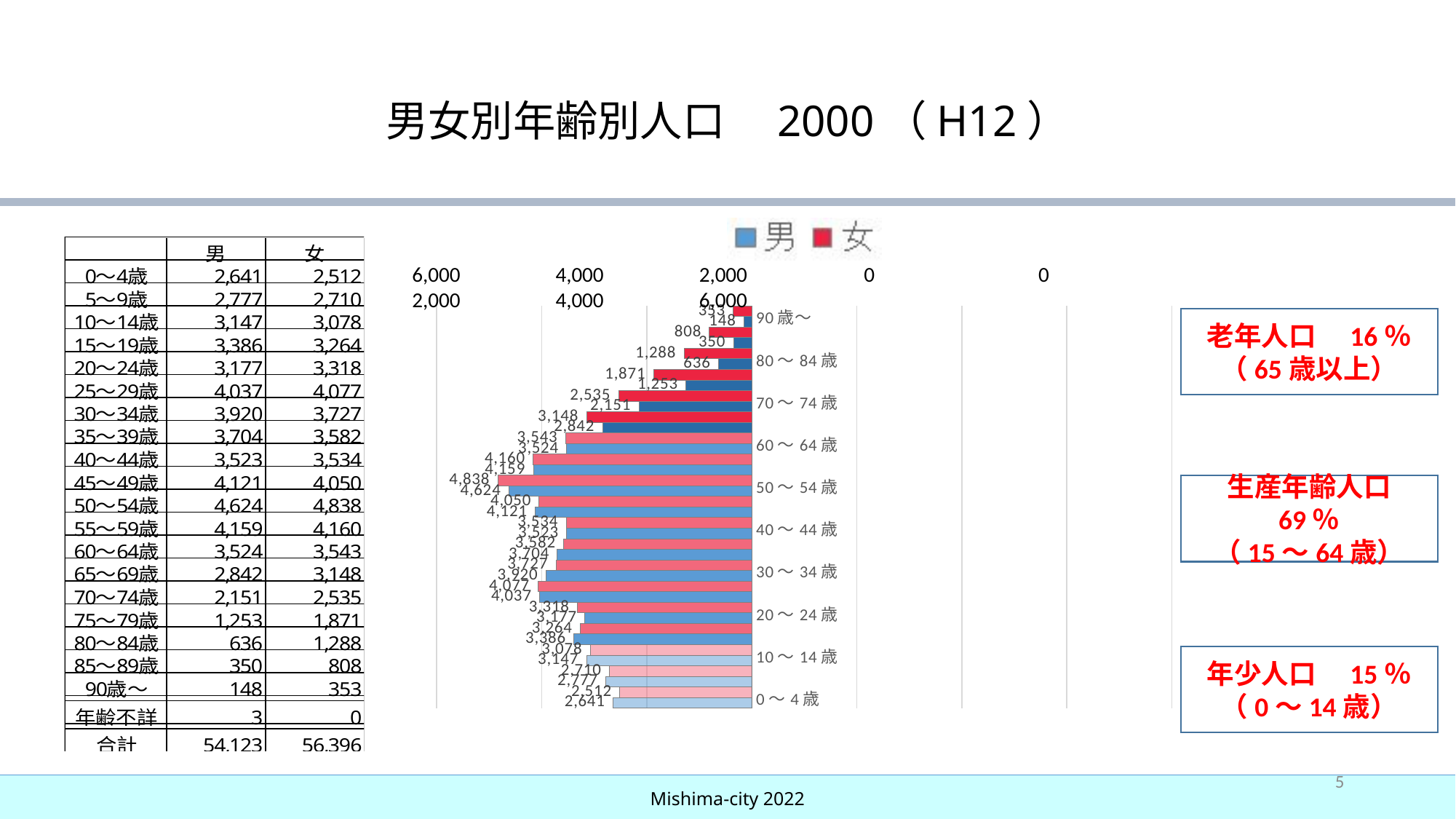
Which age group has the highest 女 value? 50〜54歳 How many age groups are plotted in the chart? 19 What is the difference between the 女 and 男 values for the 80〜84歳 age group? 652 What kind of chart is shown on the slide? bar chart What are the two legend entries of the chart? 男 and 女 How many series does the chart legend list? 2 Which age group has the lowest 男 value? 90歳〜 Which age group has the highest 男 value? 50〜54歳 What is the 男 value for the 80〜84歳 age group? 636 What is the 男 value for the 70〜74歳 age group? 2,151 For the 70〜74歳 age group, which is larger, the 男 value or the 女 value? 女 What is the 女 value for the 90歳〜 age group? 353